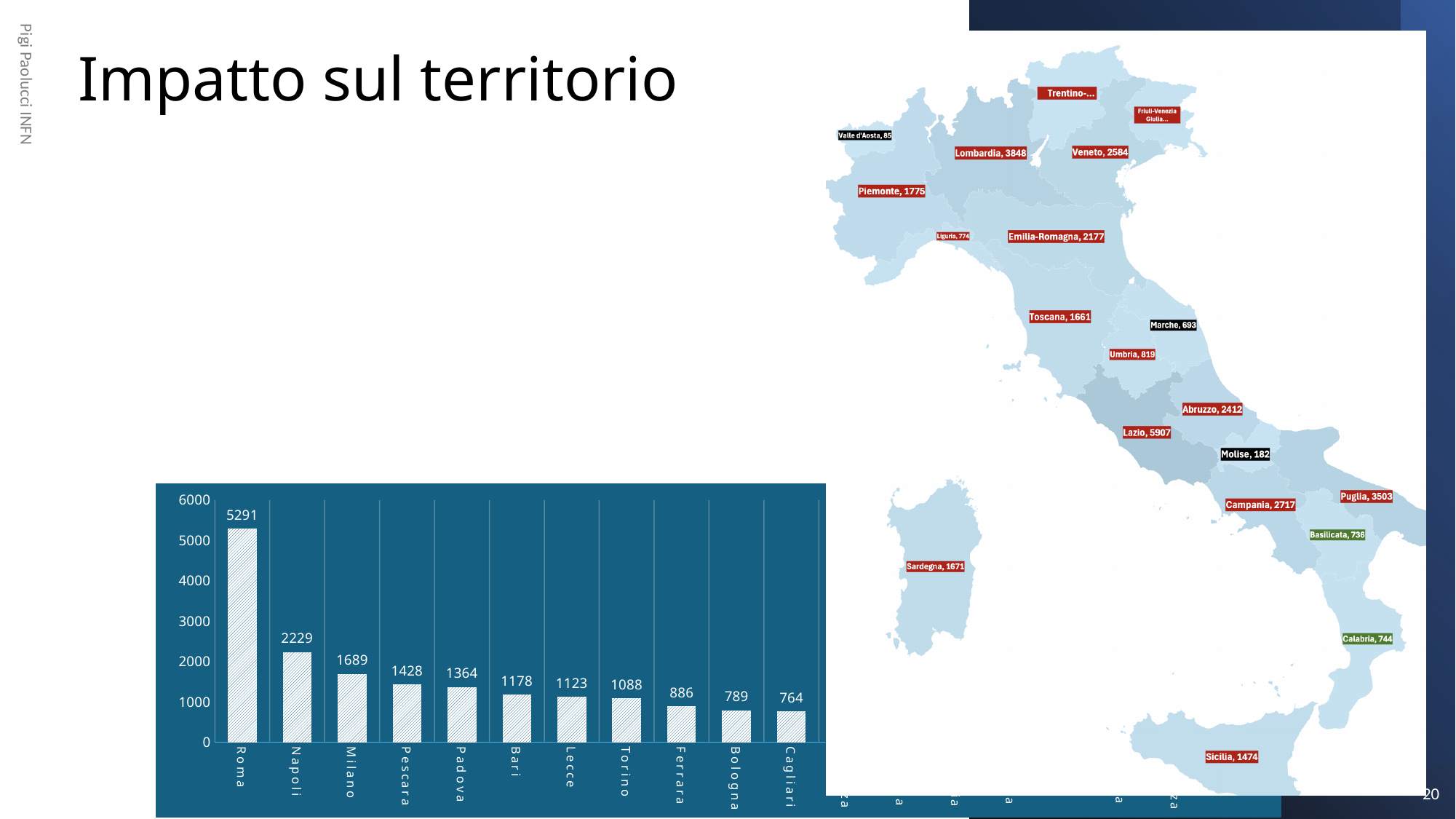
In the bar chart at the bottom left, which city has the highest value? Roma What kind of chart is shown at the bottom left of the slide? bar chart In the map chart of Italy, what is the value for Lazio? 5907 In the map chart of Italy, which region has the lowest labelled value? Valle d'Aosta In the map chart of Italy, which is larger, the value for Sardegna or the value for Sicilia? Sardegna In the map chart of Italy, what is the value for Lombardia? 3848 In the bar chart at the bottom left, what is the difference between the values for Roma and Napoli? 3062 In the bar chart at the bottom left, do the values rise or fall from left to right along the x axis? fall In the bar chart at the bottom left, what is the value for Pescara? 1428 In the bar chart at the bottom left, which is larger, the value for Milano or the value for Torino? Milano In the bar chart at the bottom left, what is the value for Roma? 5291 In the map chart of Italy, what is the difference between the values for Puglia and Campania? 786